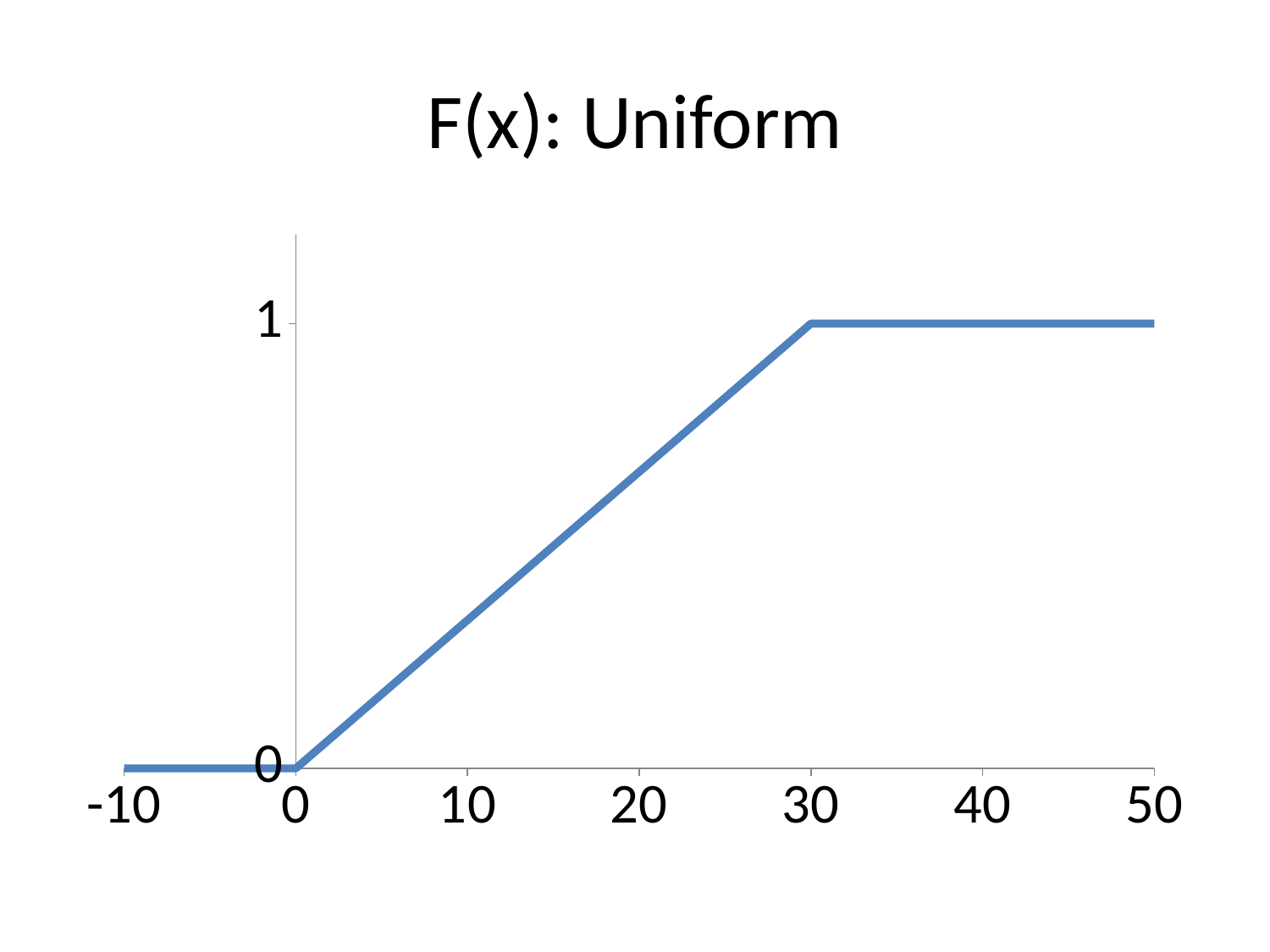
What is the value of F(x) at x = 30? 1 Which is larger, the value of F(x) at x = 10 or at x = 20? x = 20 What is the value of F(x) at x = -10? 0 What is the highest value the line reaches on the y axis? 1 Does the line rise or fall between x = 0 and x = 30? rise What is the difference between the value of F(x) at x = 30 and at x = 0? 1 What is the title of the chart? F(x): Uniform What kind of chart is shown on the slide? line chart Is the value of F(x) at x = 10 greater or less than 1? less What is the value of F(x) at x = 0? 0 What is the value of F(x) at x = 50? 1 Is the value of F(x) at x = 20 greater or less than 0? greater